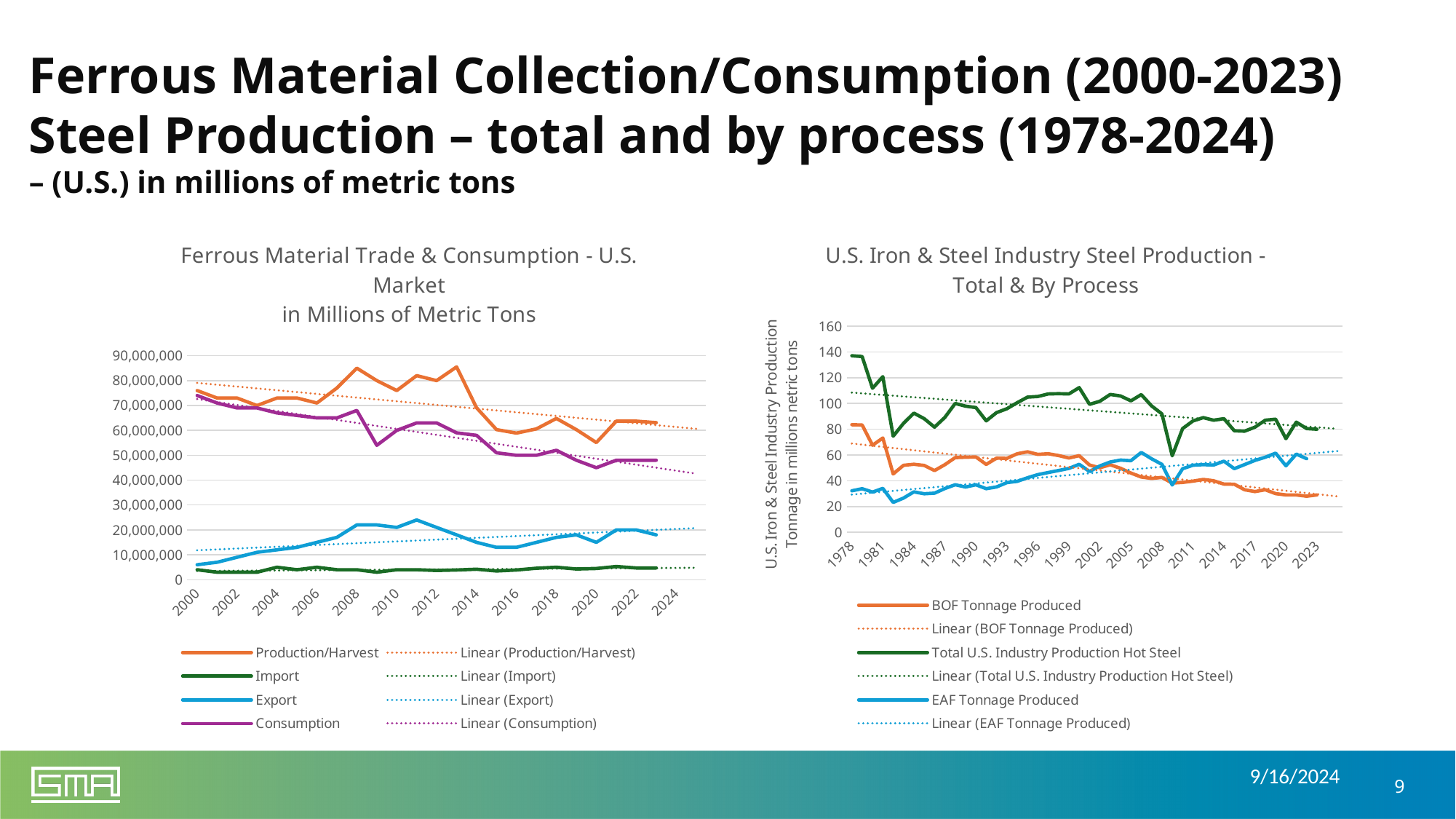
What is the y-axis label of the right chart? U.S. Iron & Steel Industry Production Tonnage in millions metric tons In the right chart, is the BOF Tonnage Produced value for 2023 greater or less than 40? less In the left chart, is the Consumption value for 2020 greater or less than 50,000,000? less What kind of chart is the 'Ferrous Material Trade & Consumption - U.S. Market' chart on the left? Line chart How many entries does the legend of the left chart, 'Ferrous Material Trade & Consumption - U.S. Market', list? 8 In the right chart, does the BOF Tonnage Produced line generally rise or fall from 1978 to 2023? Fall In the right chart, is the Total U.S. Industry Production Hot Steel value for 1978 greater or less than 120? greater How many entries does the legend of the 'U.S. Iron & Steel Industry Steel Production - Total & By Process' chart list? 6 In the right chart, does the EAF Tonnage Produced line generally rise or fall from 1978 to 2023? Rise